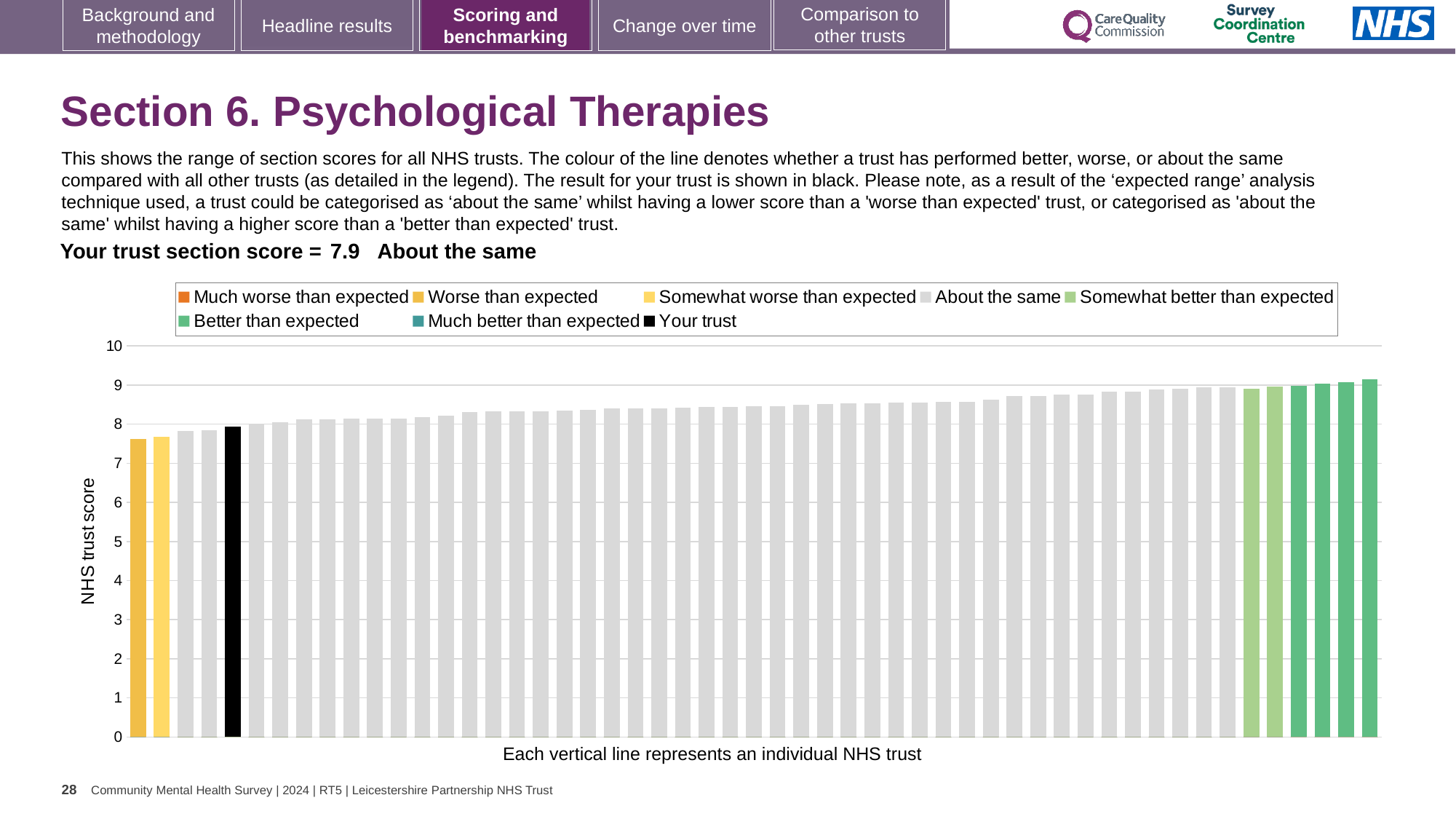
What is the trust's section score for Section 6 Psychological Therapies? 7.9 How many bars are coloured yellow (worse than expected)? 2 What type of chart is shown on the slide? Bar chart Is the value of the leftmost bar greater or less than 8? less Do the bar values rise or fall from left to right across the chart? rise What colour is used for the bar representing your trust? Black What is the label on the vertical axis of the chart? NHS trust score Is the leftmost bar higher or lower than the black bar for your trust? lower Is the value of the rightmost bar greater or less than 8? greater Is the value of the black bar (your trust) greater or less than 7? greater How many entries does the chart legend list? 8 Which performance category is the trust's section score placed in? About the same